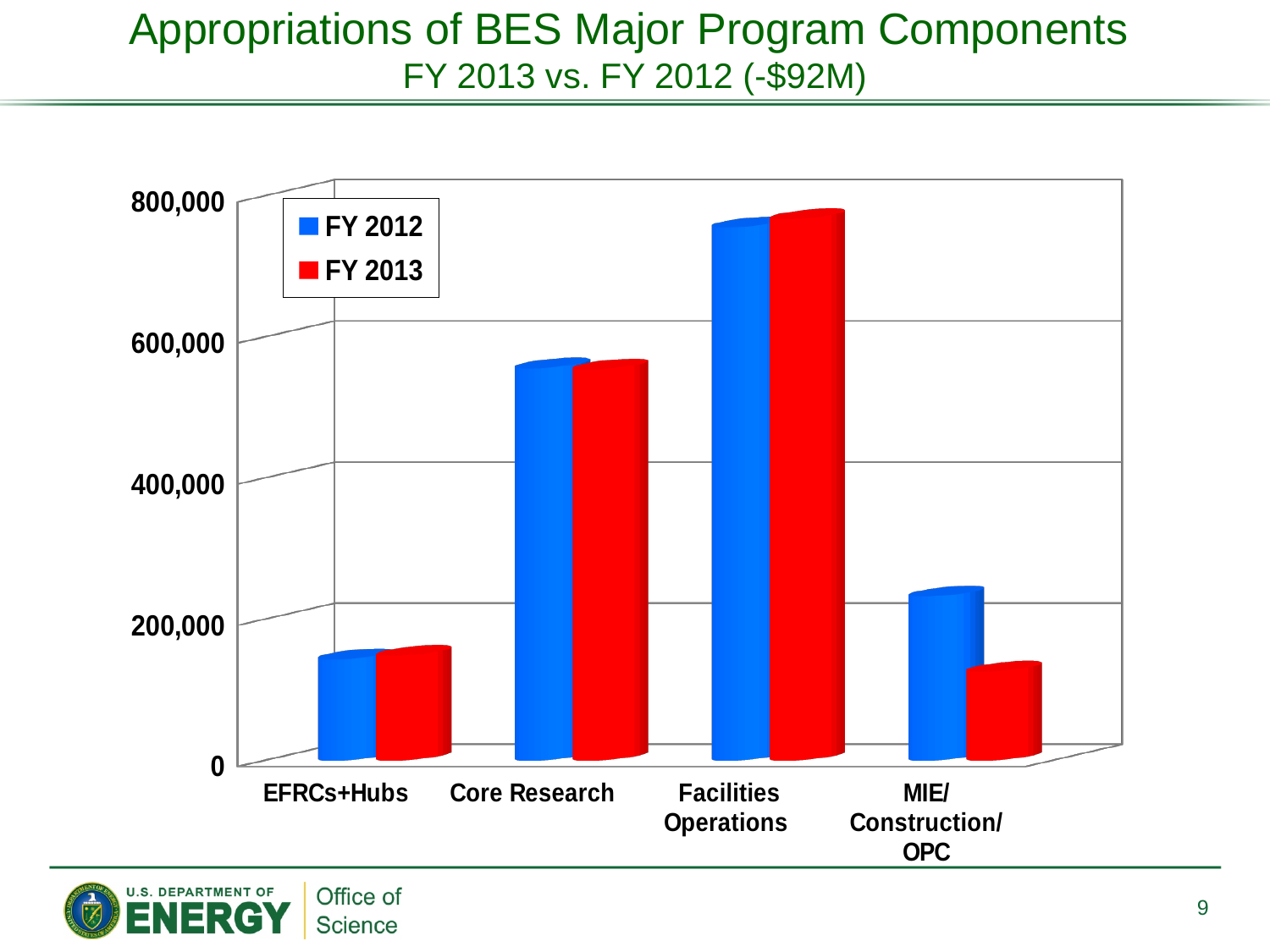
What kind of chart is shown on the slide? bar chart Is the FY 2012 value for EFRCs+Hubs greater or less than 200,000? less Which series is shown in red in the chart's legend? FY 2013 For MIE/Construction/OPC, which is larger: the FY 2012 value or the FY 2013 value? FY 2012 Which category has the highest FY 2013 value? Facilities Operations Is the FY 2012 value for MIE/Construction/OPC greater or less than 200,000? greater Is the FY 2013 value for MIE/Construction/OPC greater or less than 200,000? less How many categories are shown on the x axis of the chart? 4 Which category has the highest FY 2012 value? Facilities Operations How many series does the chart's legend list? 2 Which category has the lowest FY 2012 value? EFRCs+Hubs